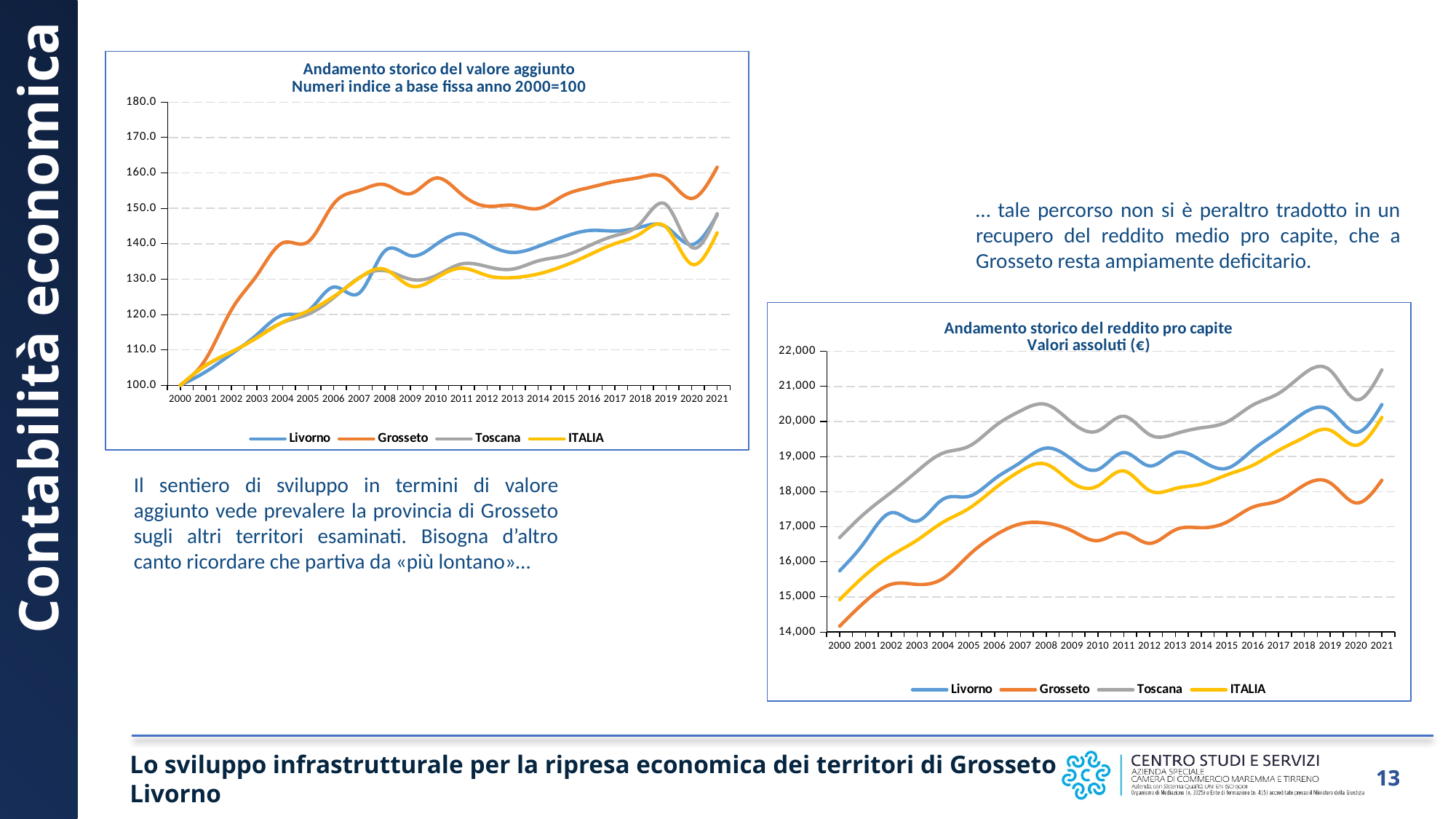
How many years are shown on the x axis of the 'Andamento storico del valore aggiunto' chart? 22 In the 'Andamento storico del valore aggiunto' chart, do the values for Grosseto generally rise or fall from 2000 to 2021? rise In the 'Andamento storico del reddito pro capite' chart, is the value for Grosseto in 2021 greater or less than 19,000? less In the 'Andamento storico del valore aggiunto' chart, is the value for Grosseto in 2010 greater or less than 150.0? greater In the 'Andamento storico del reddito pro capite' chart, which series has the lowest value in 2021? Grosseto In the 'Andamento storico del reddito pro capite' chart, which series has the highest value in 2018? Toscana What kind of chart is the 'Andamento storico del valore aggiunto' chart? line chart In the 'Andamento storico del valore aggiunto' chart, which series has the highest value in 2021? Grosseto In the 'Andamento storico del valore aggiunto' chart, is the value for Livorno in 2021 greater or less than 150.0? less How many series does the legend of the 'Andamento storico del reddito pro capite' chart list? 4 In the 'Andamento storico del reddito pro capite' chart, which is larger in 2021: Livorno or ITALIA? Livorno